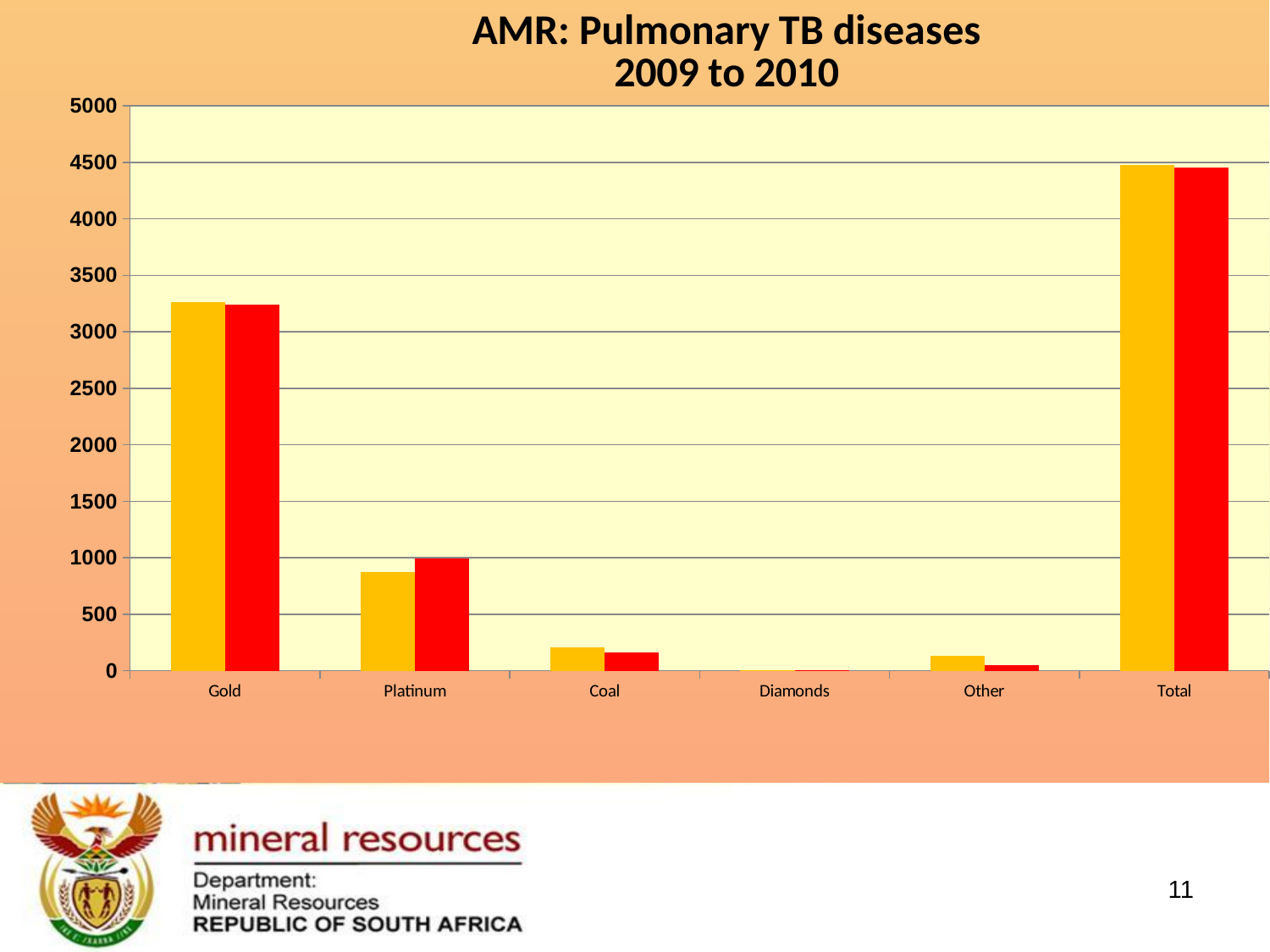
Is the value of the red bar for Coal greater or less than 500? less Which category has the highest bars on the chart? Total How many bars are plotted for each category on the chart? 2 What type of chart is shown on the slide? bar chart What is the title of the chart? AMR: Pulmonary TB diseases 2009 to 2010 How many categories are shown on the x axis of the chart? 6 Which category has the lowest bars on the chart? Diamonds Which is larger, the yellow bar for Coal or the yellow bar for Other? Coal Is the value of the yellow bar for Gold greater or less than 3000? greater Excluding Total, which category has the highest bars on the chart? Gold Is the value of the yellow bar for Platinum greater or less than 1000? less